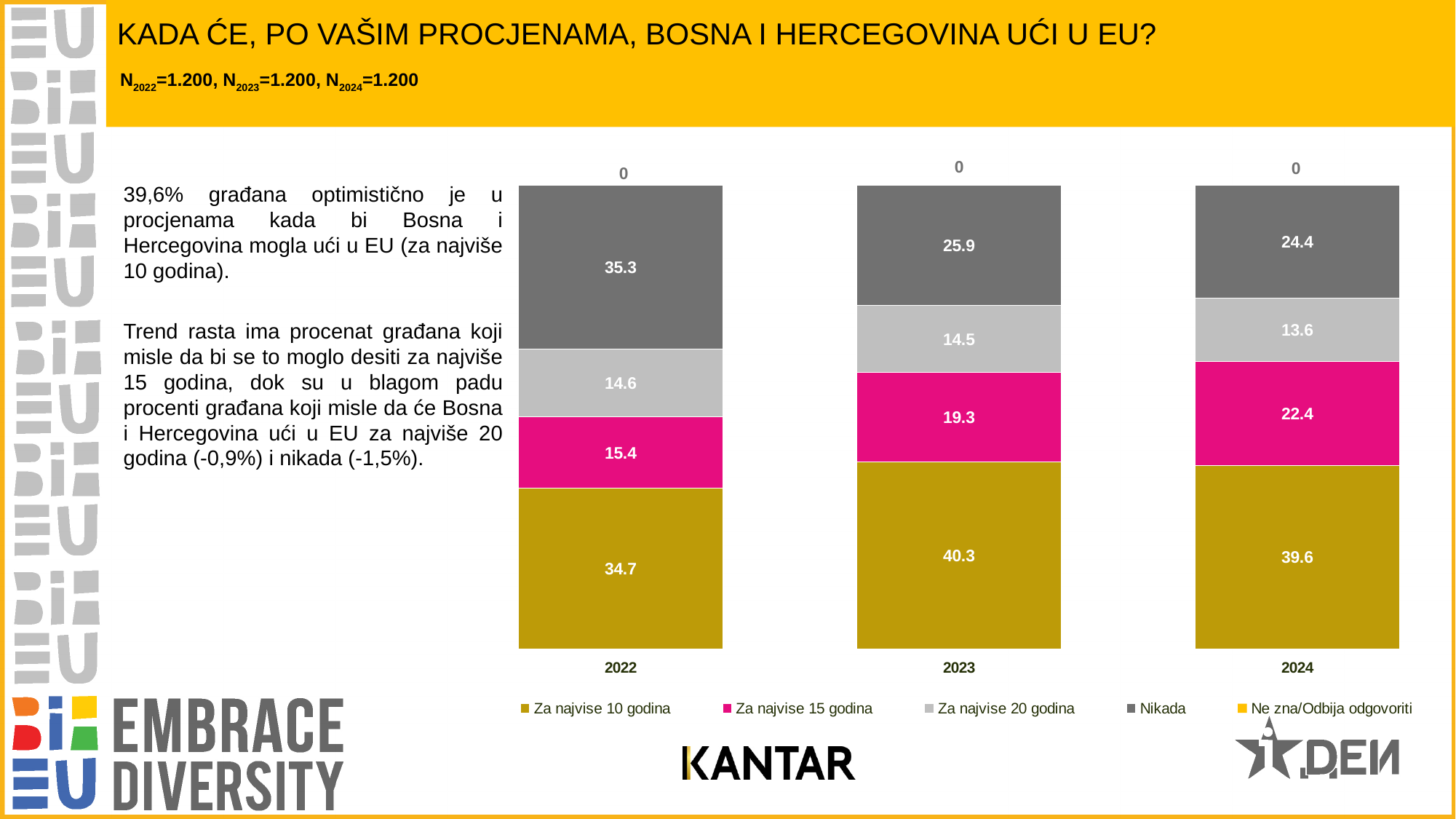
What is the value for "Za najvise 15 godina" in 2024? 22.4 What type of chart is shown on the slide? Stacked bar chart What is the difference between the "Nikada" values in 2022 and 2024? 10.9 How many years are shown on the x axis? 3 How does the value for "Za najvise 15 godina" change from 2022 to 2024? It rises In which year is the value for "Nikada" the lowest? 2024 How many series does the legend list? 5 Which is larger in 2022: "Za najvise 10 godina" or "Nikada"? Nikada What is the value for "Nikada" in 2022? 35.3 What is the value for "Za najvise 10 godina" in 2023? 40.3 In which year is the value for "Za najvise 15 godina" the highest? 2024 What is the value for "Za najvise 20 godina" in 2023? 14.5